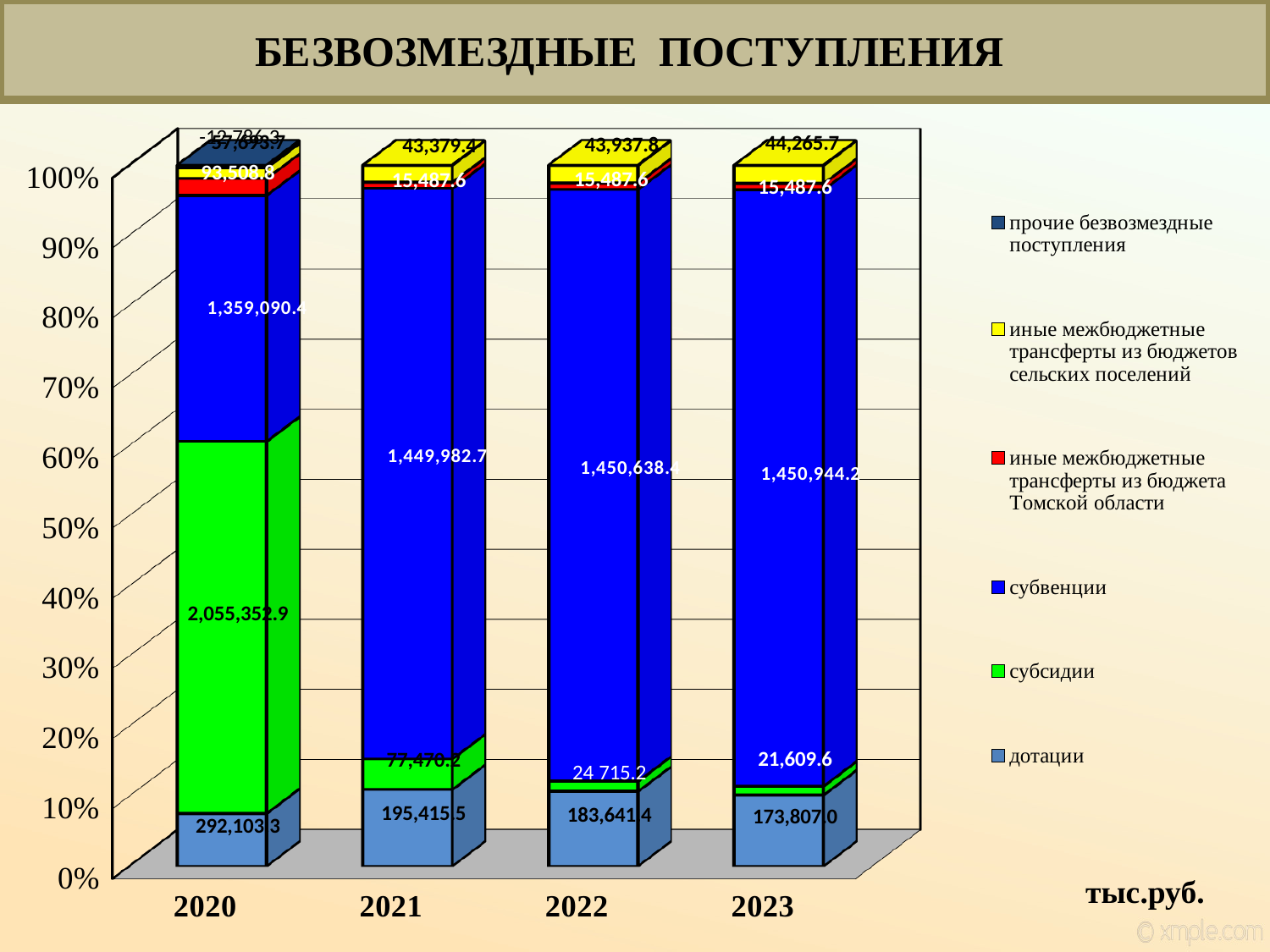
What is the value of субвенции for 2023? 1,450,944.2 How many series does the legend list? 6 How many years are shown on the x axis? 4 Which is larger, дотации in 2021 or дотации in 2023? дотации in 2021 What is the value of иные межбюджетные трансферты из бюджета Томской области for 2021? 15,487.6 What is the value of субсидии for 2021? 77,470.2 What is the title of the chart? БЕЗВОЗМЕЗДНЫЕ ПОСТУПЛЕНИЯ What kind of chart is shown on the slide? stacked bar chart What is the value of дотации for 2020? 292,103.3 What is the value of иные межбюджетные трансферты из бюджетов сельских поселений for 2022? 43,937.8 What is the difference between дотации in 2021 and дотации in 2022? 11,774.1 Do the values of дотации rise or fall from 2020 to 2023? fall